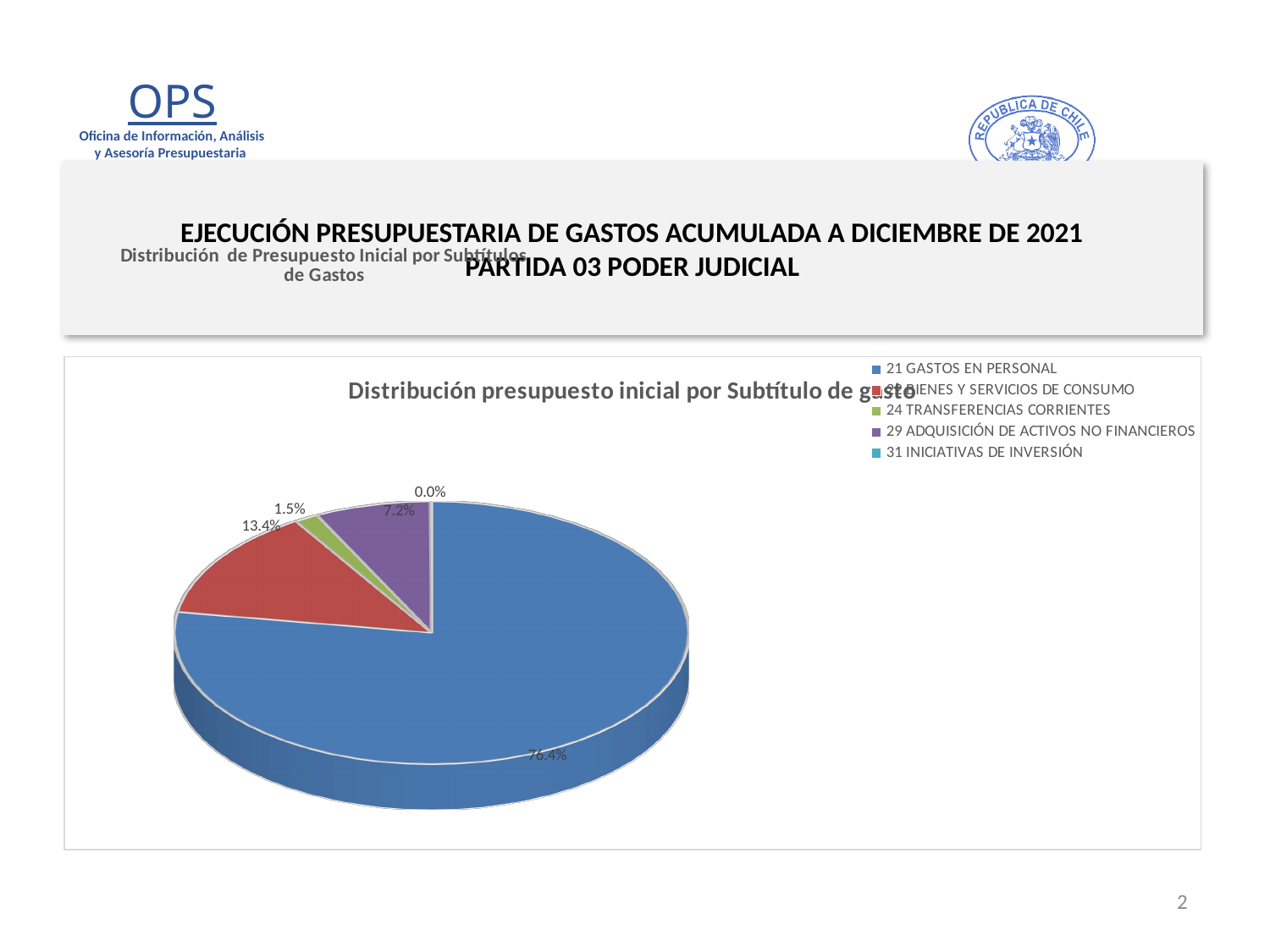
What percentage is shown for 29 ADQUISICIÓN DE ACTIVOS NO FINANCIEROS? 7.2% What percentage of the pie does 21 GASTOS EN PERSONAL represent? 76.4% What kind of chart is shown on the slide? Pie chart What is the difference in percentage points between 21 GASTOS EN PERSONAL and 29 ADQUISICIÓN DE ACTIVOS NO FINANCIEROS? 69.2% What is the title of the chart? Distribución presupuesto inicial por Subtítulo de gasto Which has a larger share, 29 ADQUISICIÓN DE ACTIVOS NO FINANCIEROS or 24 TRANSFERENCIAS CORRIENTES? 29 ADQUISICIÓN DE ACTIVOS NO FINANCIEROS How many categories does the legend list? 5 Which category has the smallest share of the pie? 31 INICIATIVAS DE INVERSIÓN What percentage is shown for 24 TRANSFERENCIAS CORRIENTES? 1.5% What percentage is shown for 22 BIENES Y SERVICIOS DE CONSUMO? 13.4% What percentage is shown for 31 INICIATIVAS DE INVERSIÓN? 0.0% Which category has the largest share of the pie? 21 GASTOS EN PERSONAL